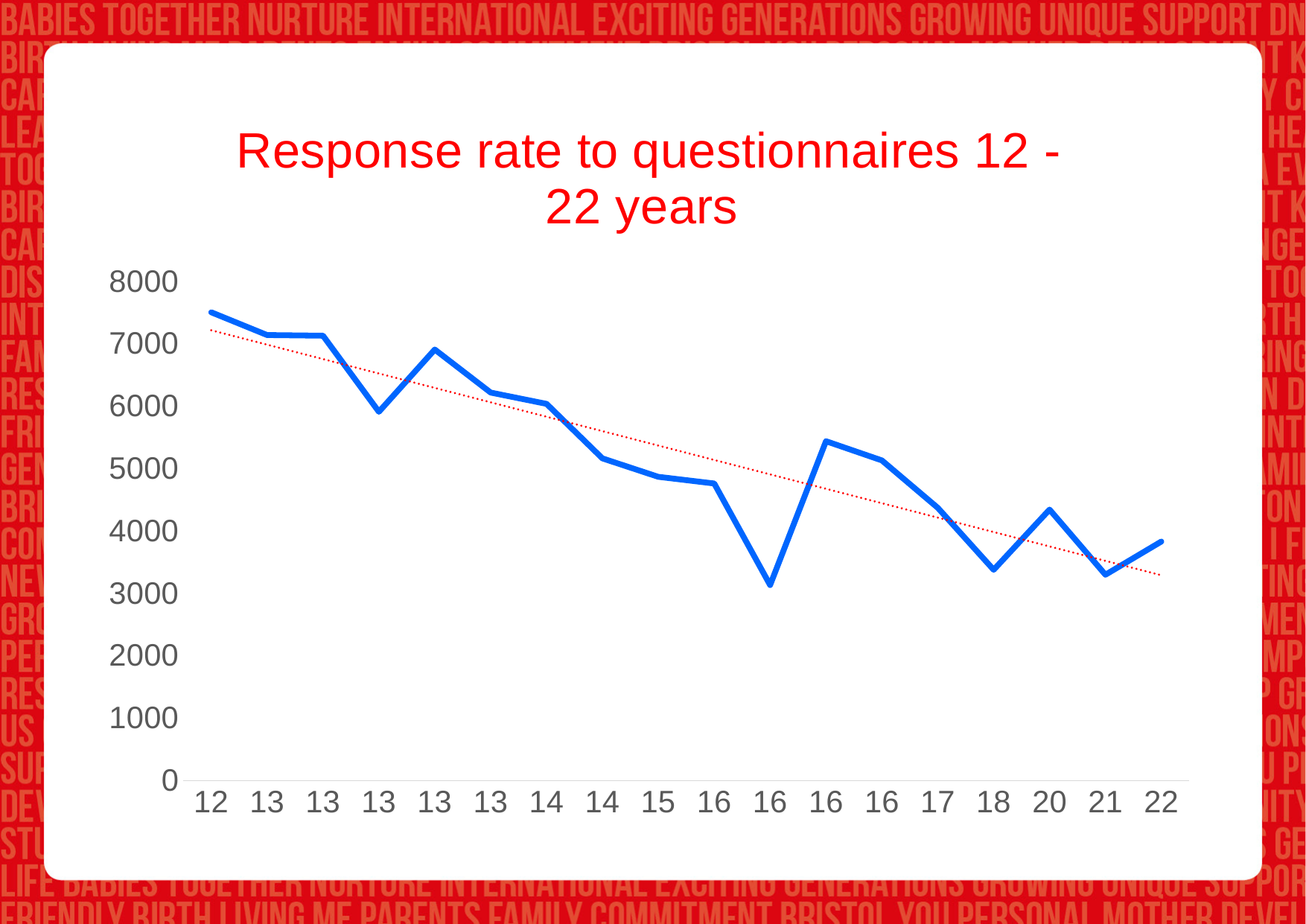
Which is larger, the value for 12 or the value for 22? 12 Is the value for 22 greater or less than 4000? less What is the title of the chart? Response rate to questionnaires 12 - 22 years Do the values generally rise or fall along the x axis from 12 to 22? fall How many data points are plotted on the line? 18 What colour is the dotted trend line on the chart? red Which x-axis label has the highest value? 12 Is the value for 20 greater or less than 4000? greater Is the value for 12 greater or less than 7000? greater What kind of chart is shown on the slide? line chart